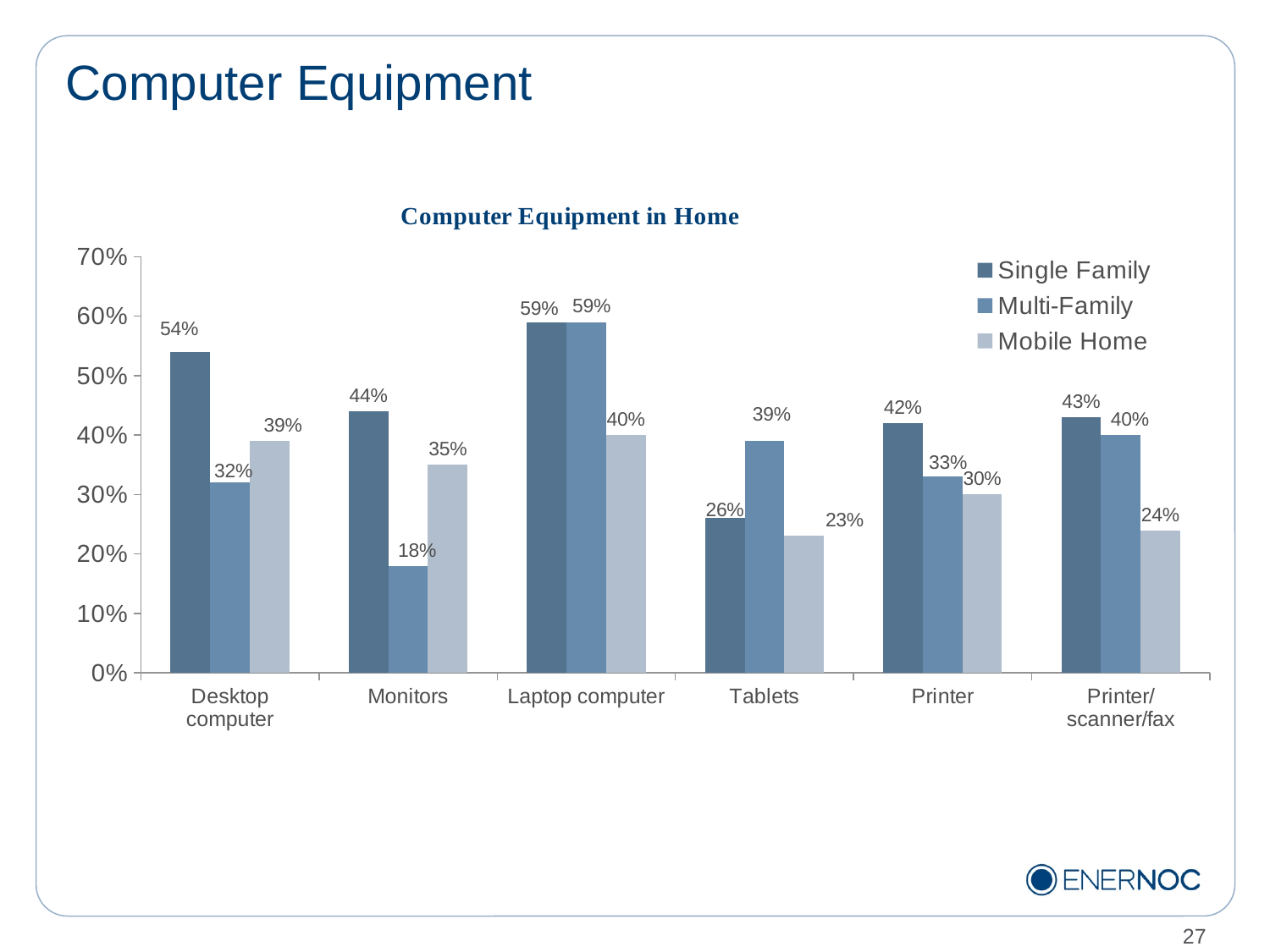
Which category has the lowest Multi-Family value? Monitors What kind of chart is shown? Bar chart What is the Mobile Home value for Printer/scanner/fax? 24% What is the Mobile Home value for Tablets? 23% Which category has the highest Single Family value? Laptop computer What is the Multi-Family value for Monitors? 18% Which is larger for Tablets: the Single Family value or the Multi-Family value? Multi-Family What is the title of the chart? Computer Equipment in Home What is the difference between the Single Family and Multi-Family values for Desktop computer? 22% How many categories are shown on the x axis? 6 How many series does the legend list? 3 What is the Single Family value for Desktop computer? 54%